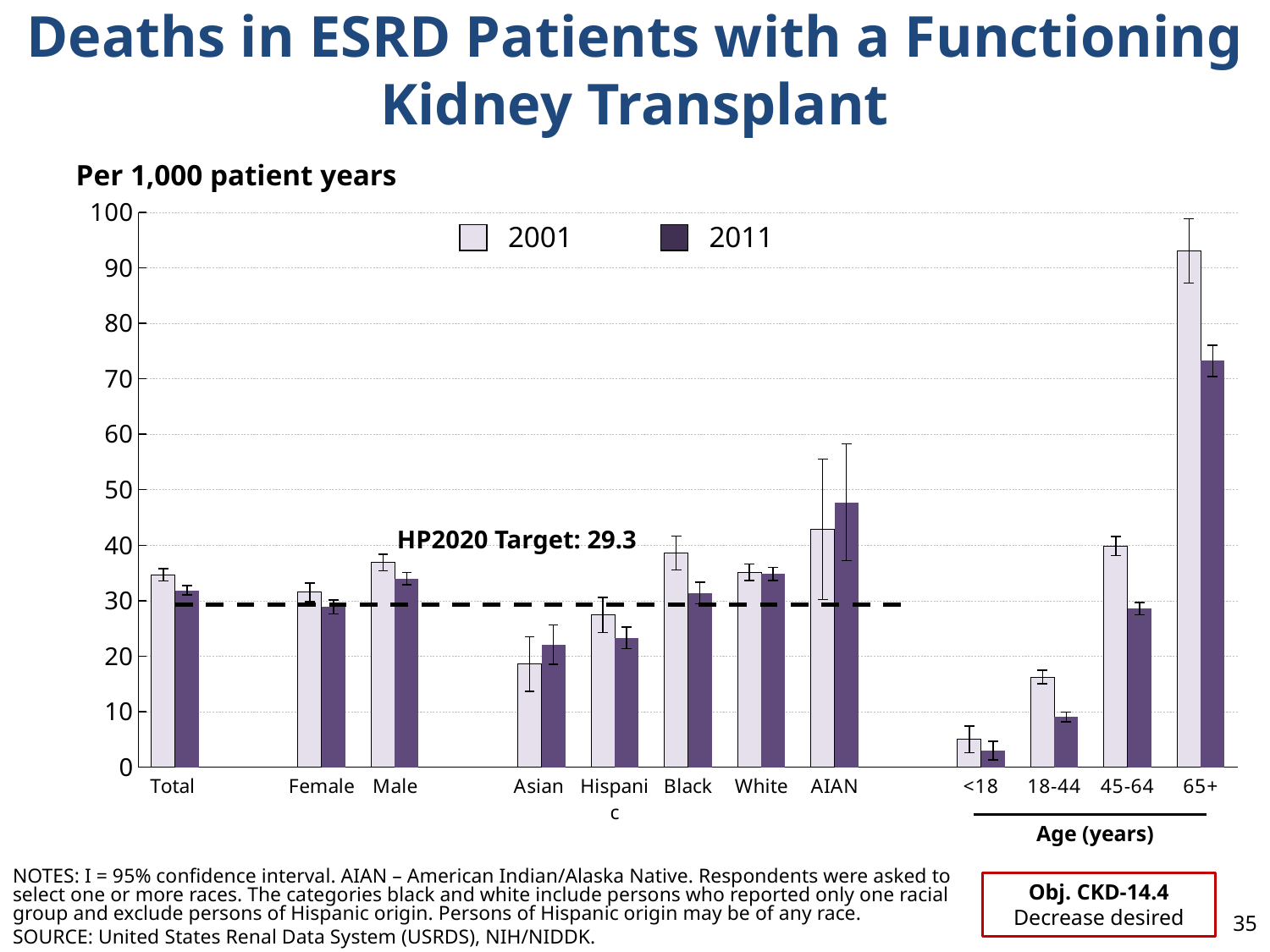
How many series does the legend list? 2 For the AIAN category, which year has the larger value, 2001 or 2011? 2011 Is the 2011 value for AIAN greater or less than 40? greater Is the 2001 value for 65+ greater or less than 80? greater What is the HP2020 Target value shown by the dashed line? 29.3 For the 65+ category, which year has the larger value, 2001 or 2011? 2001 Which category has the highest value for 2001? 65+ Is the 2001 value for Asian greater or less than 30? less How many categories are shown along the x axis? 12 Which category has the lowest value for 2011? <18 What kind of chart is shown on the slide? bar chart